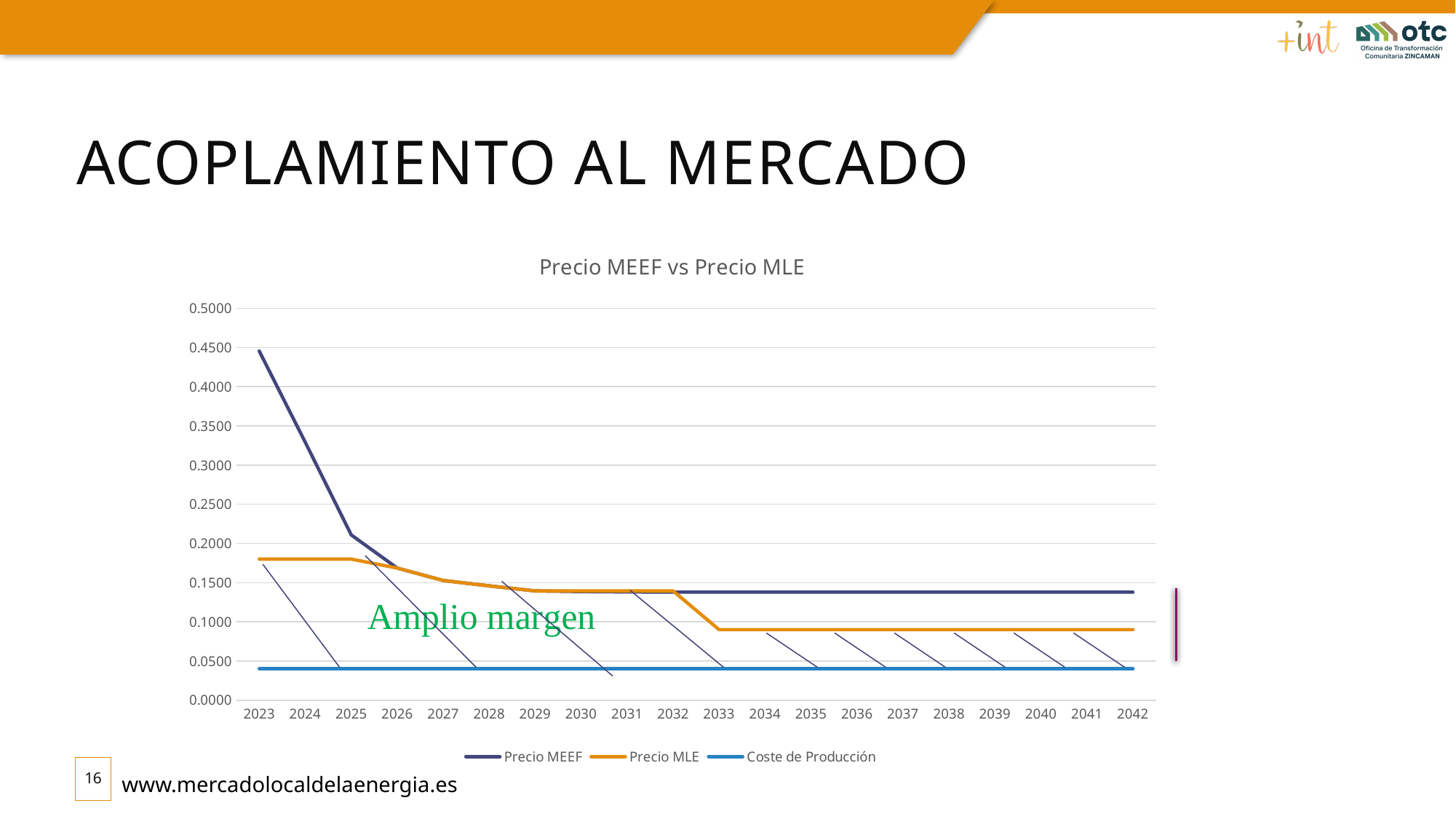
Is the value for Precio MLE in 2023 greater or less than 0.2000? less How many years are shown on the x axis of the chart? 20 Is the value for Precio MEEF in 2023 greater or less than 0.4000? greater Does the Precio MEEF line rise or fall from 2023 to 2033? fall What kind of chart is shown on the slide? line chart Which year has the highest value for Precio MEEF? 2023 In 2023, which is larger: Precio MEEF or Precio MLE? Precio MEEF What is the title of the chart? Precio MEEF vs Precio MLE Is the value for Precio MEEF in 2042 greater or less than 0.1500? less How many series does the legend list? 3 In 2042, which is larger: Precio MLE or Coste de Producción? Precio MLE